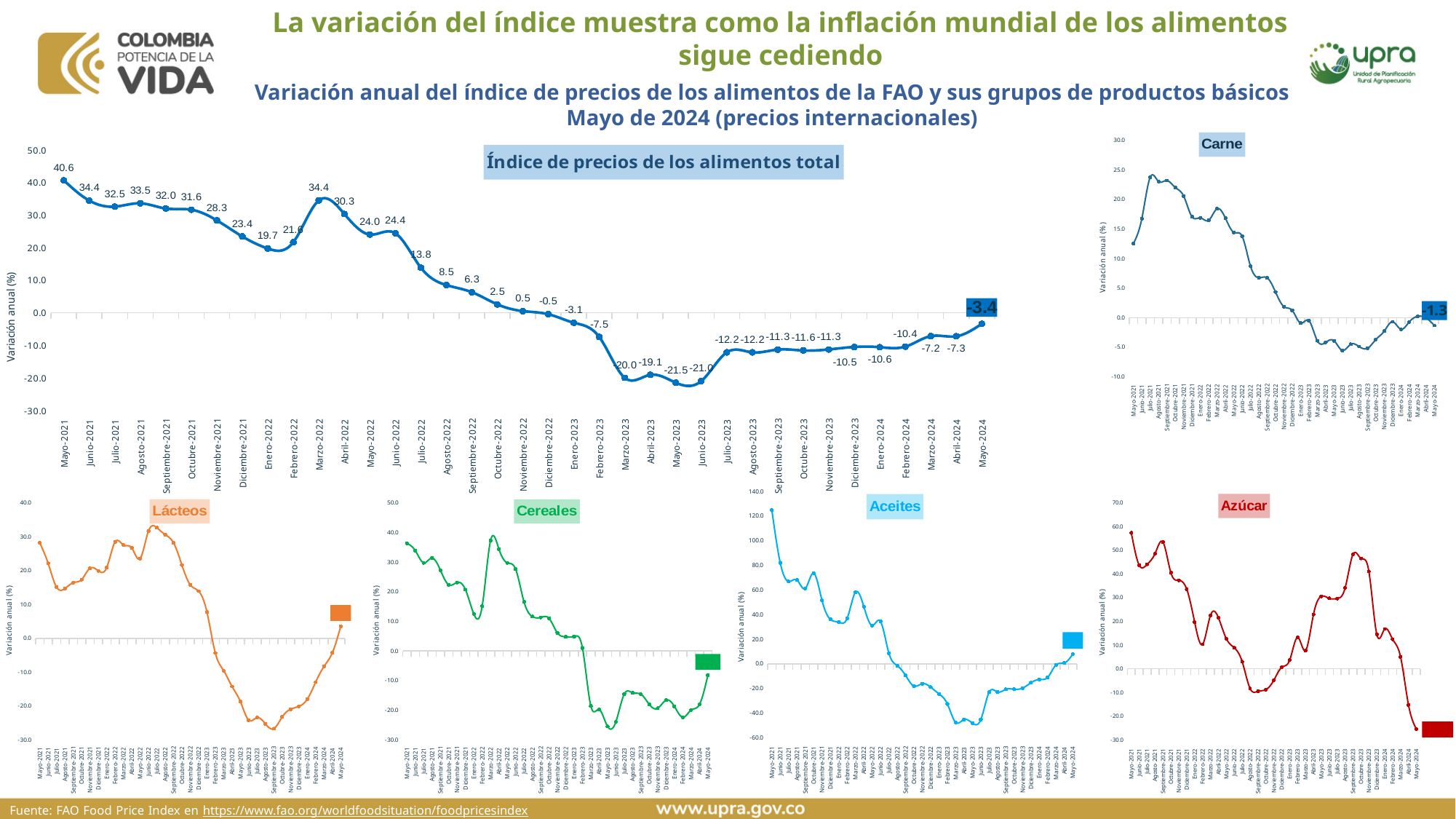
In the 'Índice de precios de los alimentos total' chart, do the values rise or fall from Mayo-2021 to Marzo-2023? Fall In the 'Aceites' chart, is the value for Mayo-2021 greater or less than 100.0? greater In the 'Índice de precios de los alimentos total' chart, which is larger, the value for Julio-2022 or the value for Agosto-2022? Julio-2022 In the 'Azúcar' chart, is the value for Mayo-2024 greater or less than -20.0? less In the 'Índice de precios de los alimentos total' chart, what is the difference between the values for Mayo-2021 and Junio-2021? 6.2 In the 'Carne' chart, what is the value for Mayo-2024? -1.3 In the 'Índice de precios de los alimentos total' chart, which month has the lowest value? Mayo-2023 What type of chart is the 'Índice de precios de los alimentos total' chart? Line chart In the 'Índice de precios de los alimentos total' chart, what is the value for Mayo-2024? -3.4 In the 'Índice de precios de los alimentos total' chart, how many data points are plotted? 37 In the 'Índice de precios de los alimentos total' chart, what is the value for Marzo-2022? 34.4 In the 'Índice de precios de los alimentos total' chart, which month has the highest value? Mayo-2021